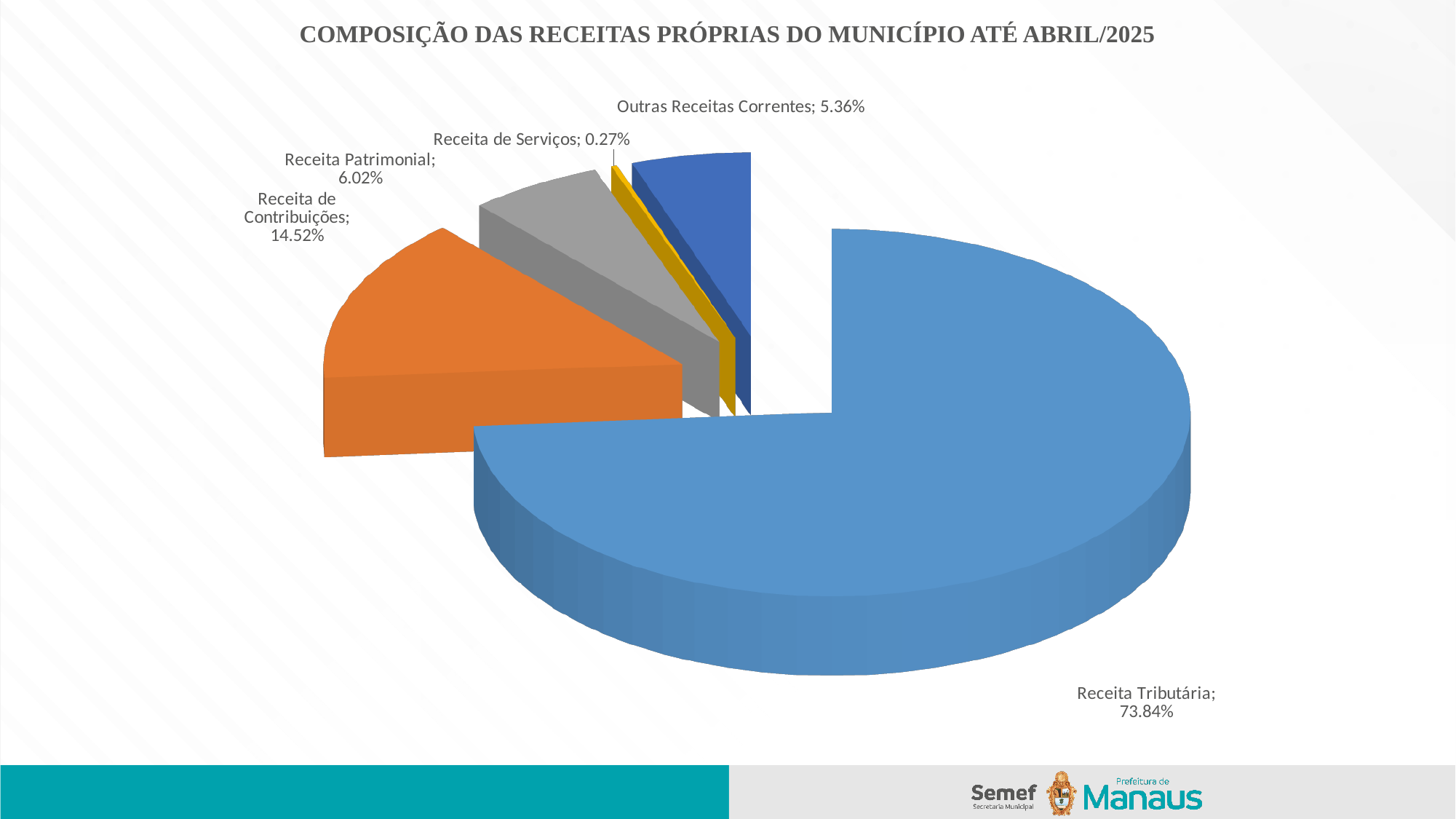
What share of the pie does Receita Tributária represent? 73.84% What is the value shown for Receita de Serviços? 0.27% What is the title of the chart? COMPOSIÇÃO DAS RECEITAS PRÓPRIAS DO MUNICÍPIO ATÉ ABRIL/2025 What is the value shown for Receita de Contribuições? 14.52% Which is larger, Receita Patrimonial or Outras Receitas Correntes? Receita Patrimonial What is the value shown for Outras Receitas Correntes? 5.36% What is the difference in percentage points between Receita Tributária and Receita de Contribuições? 59.32 Which category has the smallest slice of the pie? Receita de Serviços Which category has the largest slice of the pie? Receita Tributária How many categories are shown in the pie chart? 5 What kind of chart is shown on the slide? Pie chart What is the value shown for Receita Patrimonial? 6.02%